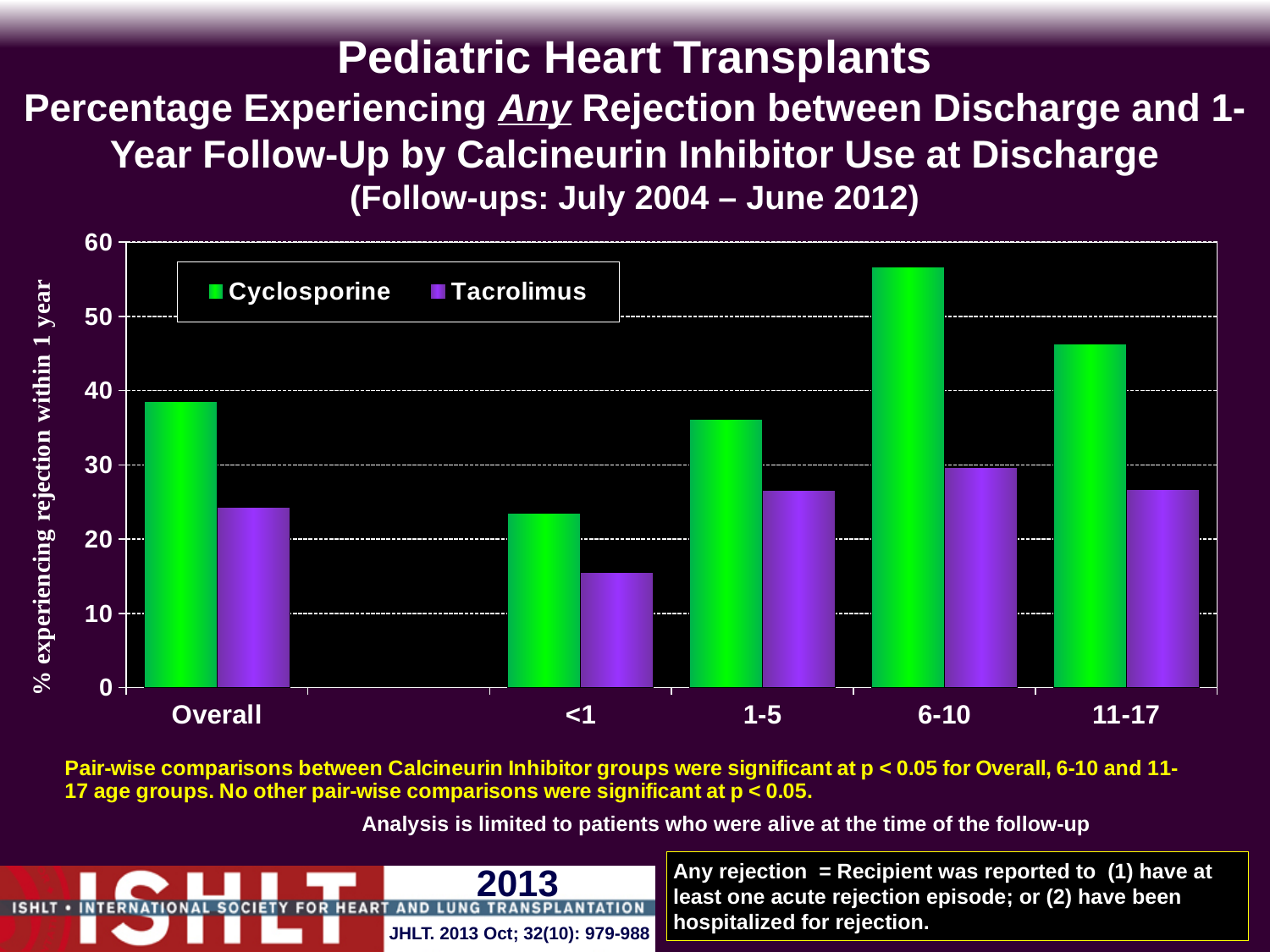
Is the Cyclosporine value for the 6-10 age group greater or less than 50? greater For the Overall category, which is larger: the Cyclosporine value or the Tacrolimus value? Cyclosporine Which category has the lowest Tacrolimus value? <1 Which category has the highest Cyclosporine value? 6-10 Which category has the highest Tacrolimus value? 6-10 Is the Tacrolimus value for the <1 age group greater or less than 20? less How many categories are shown along the x axis? 5 Which category has the lowest Cyclosporine value? <1 How many series does the legend list? 2 Is the Cyclosporine value for the 11-17 age group greater or less than 40? greater What kind of chart is shown on the slide? bar chart What is the label on the y axis of the chart? % experiencing rejection within 1 year